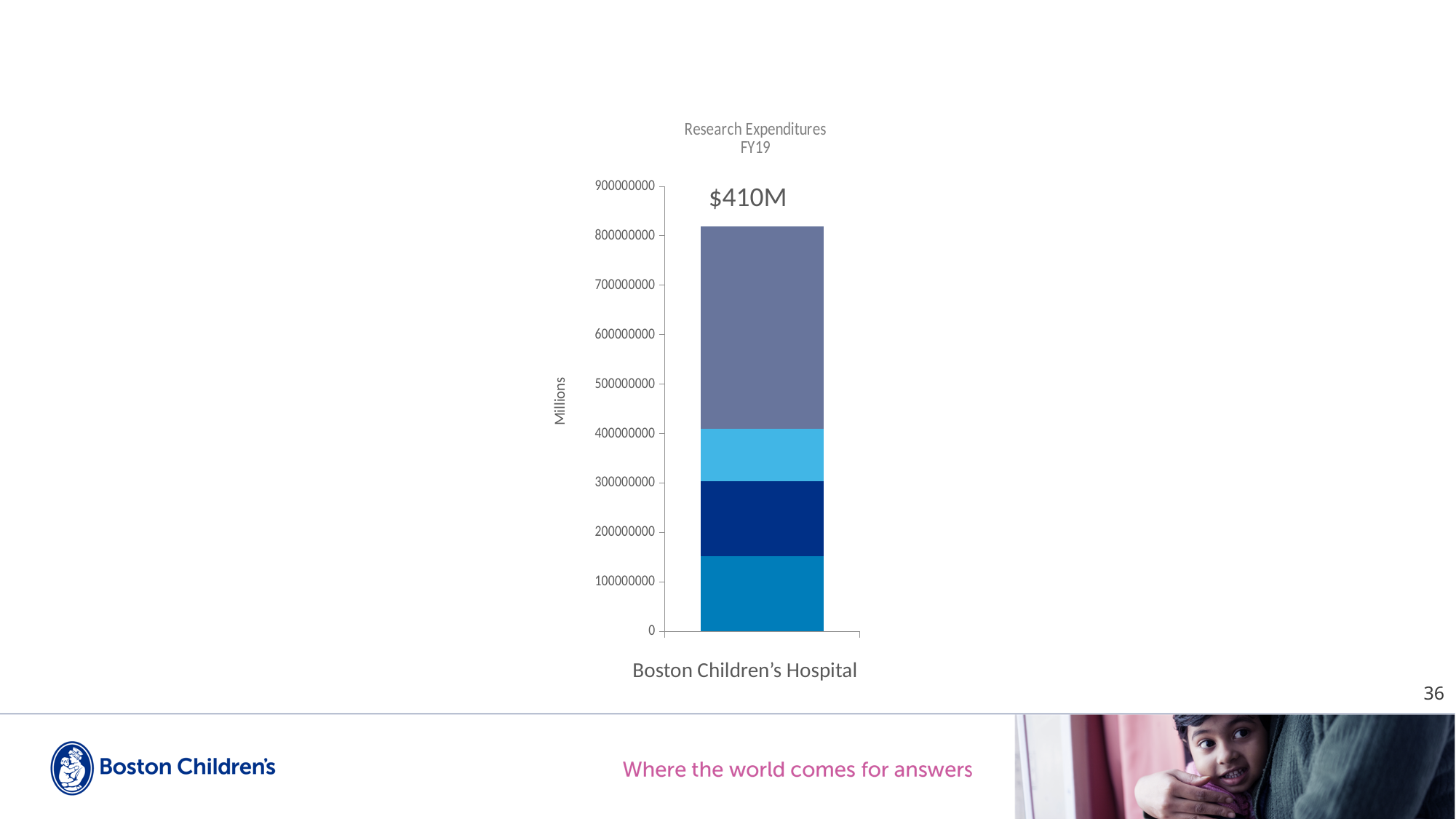
What is the highest tick value shown on the vertical axis of the chart? 900000000 What value label is printed above the bar for Boston Children's Hospital? $410M Is the total height of the bar for Boston Children's Hospital greater or less than 700000000 on the axis? greater How many stacked segments make up the bar for Boston Children's Hospital? 4 How many categories are plotted on the x axis of the chart? 1 Is the top of the bottom (medium blue) segment of the bar greater or less than 100000000 on the axis? greater What category label appears below the bar on the x axis? Boston Children's Hospital Is the top of the bottom (medium blue) segment of the bar greater or less than 200000000 on the axis? less What kind of chart is shown on the slide? Stacked bar chart What is the title of the chart? Research Expenditures FY19